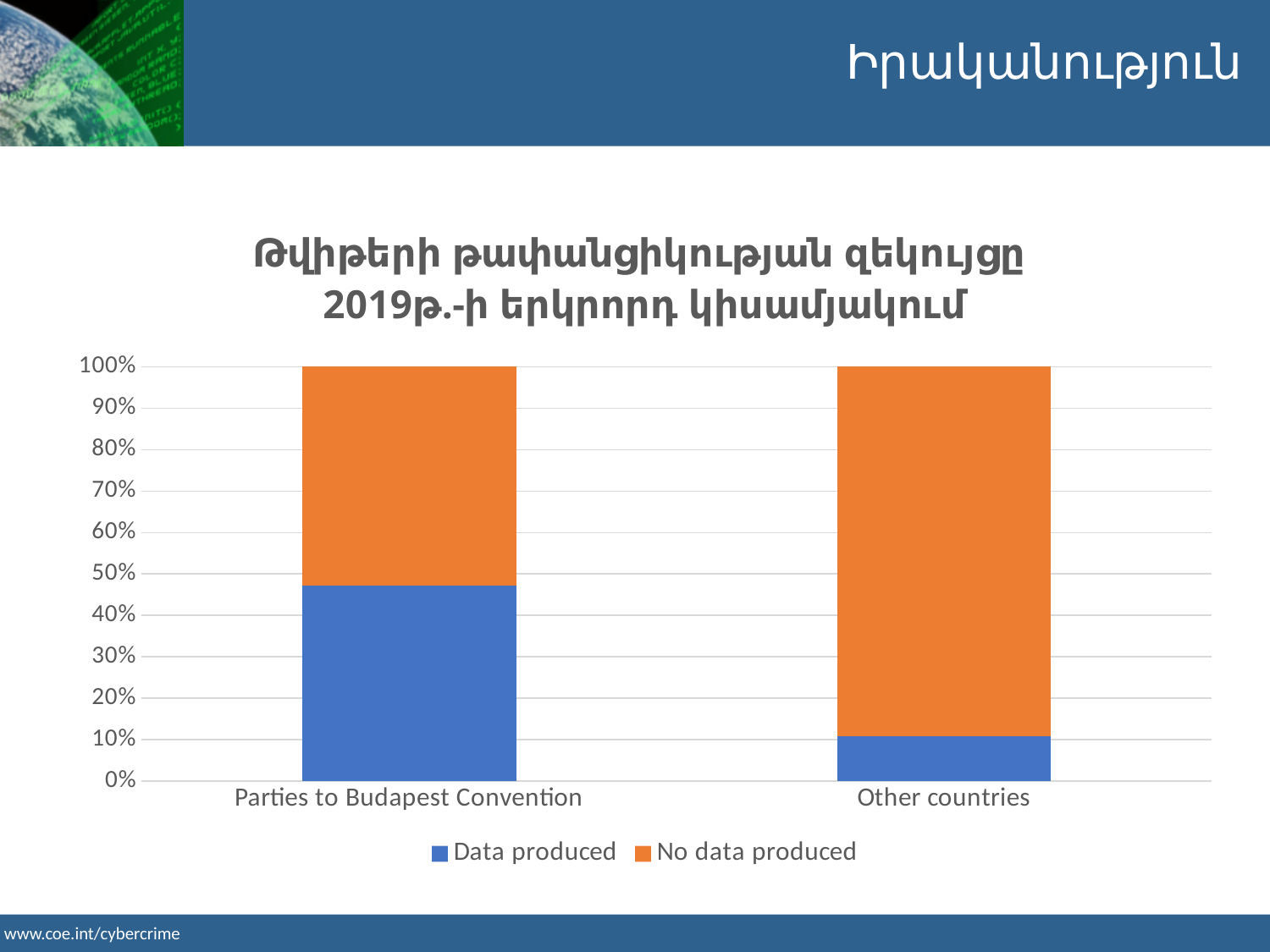
Is the 'No data produced' value for Other countries greater or less than 80%? greater How many categories are shown on the x axis of the chart? 2 Which series is shown in orange in the chart? No data produced Is the 'Data produced' value for Parties to Budapest Convention greater or less than 50%? less What is the total height of the stacked bar for Other countries? 100% Which category has the larger 'Data produced' share: Parties to Budapest Convention or Other countries? Parties to Budapest Convention Which series is shown in blue in the chart? Data produced Which category has the highest 'No data produced' share? Other countries Is the 'Data produced' value for Other countries greater or less than 20%? less How many series does the chart's legend list? 2 What kind of chart is shown on the slide? stacked bar chart